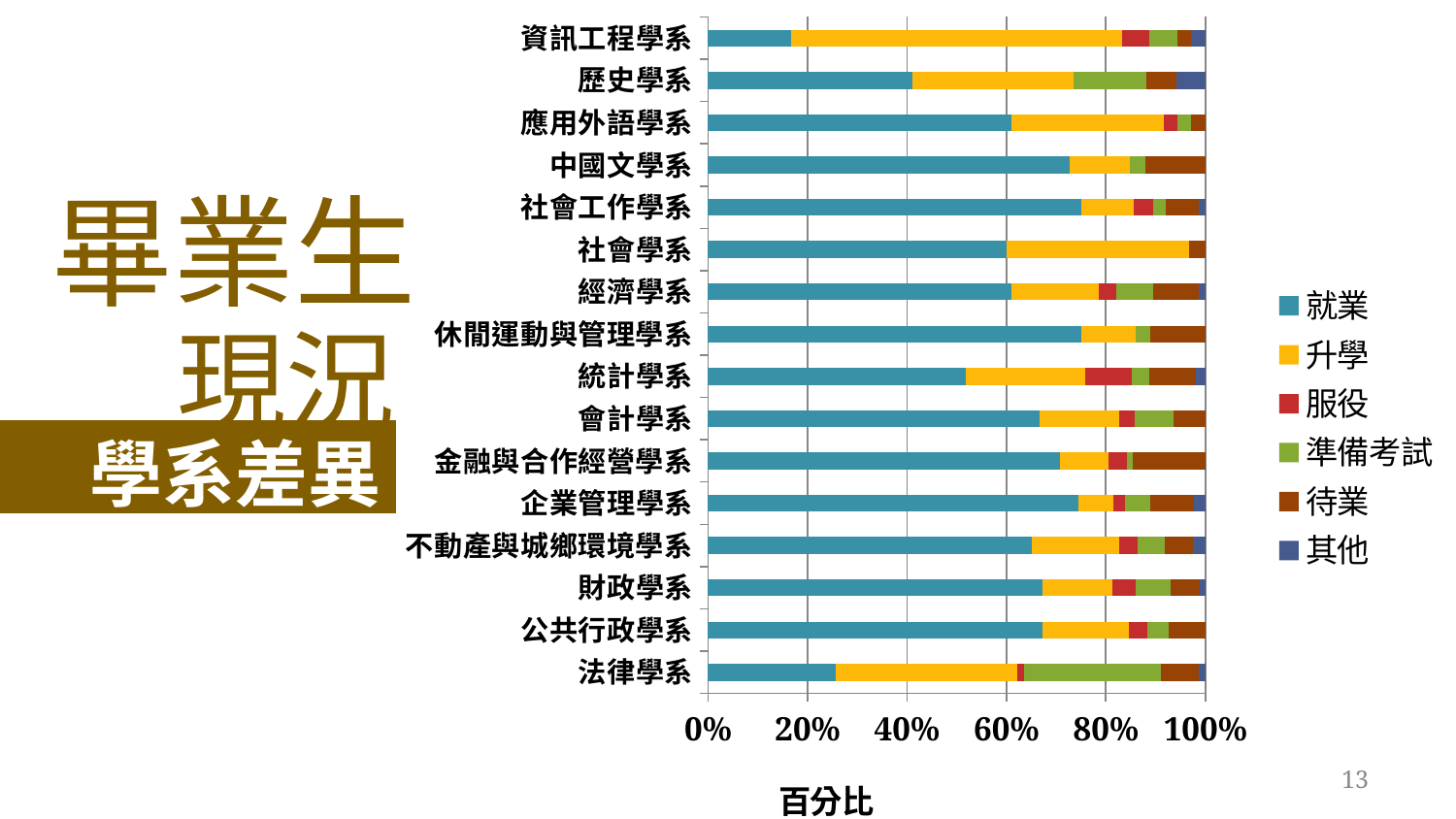
Which department has the largest 升學 segment? 資訊工程學系 Which has the larger 就業 segment, 歷史學系 or 統計學系? 統計學系 What is the title of the horizontal axis of the chart? 百分比 How many series does the chart's legend list? 6 How many departments (categories) are listed on the vertical axis of the chart? 16 Is the 就業 value for 資訊工程學系 greater or less than 20%? less Which department has the smallest 就業 segment? 資訊工程學系 What kind of chart is shown on the slide? Stacked bar chart Which legend entry is shown in blue (the first series)? 就業 Is the 就業 value for 統計學系 greater or less than 40%? greater Is the 就業 value for 中國文學系 greater or less than 60%? greater Which department has the largest 準備考試 segment? 法律學系